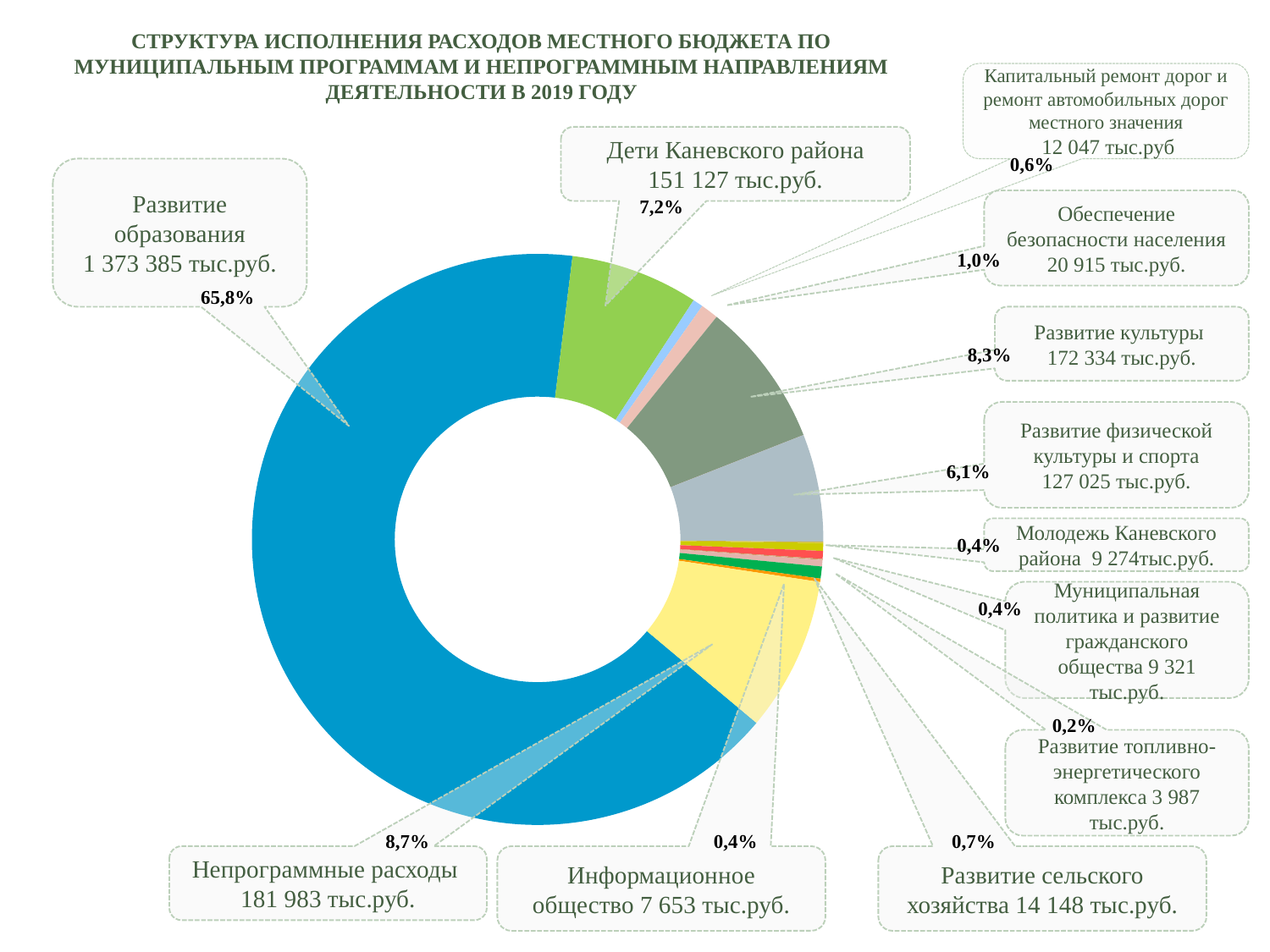
What share of the pie does «Развитие культуры» take? 8,3% What share of the pie does «Развитие сельского хозяйства» take? 0,7% What kind of chart is shown on the slide? Pie (doughnut) chart Which is larger: the value for «Развитие физической культуры и спорта» or «Дети Каневского района»? Дети Каневского района Which category has the largest share of the pie? Развитие образования What year does the chart title refer to? 2019 What is the value for «Развитие образования»? 1 373 385 тыс.руб. What is the value for «Непрограммные расходы»? 181 983 тыс.руб. What is the difference between the values for «Развитие культуры» and «Дети Каневского района»? 21 207 тыс.руб. What is the value for «Обеспечение безопасности населения»? 20 915 тыс.руб.